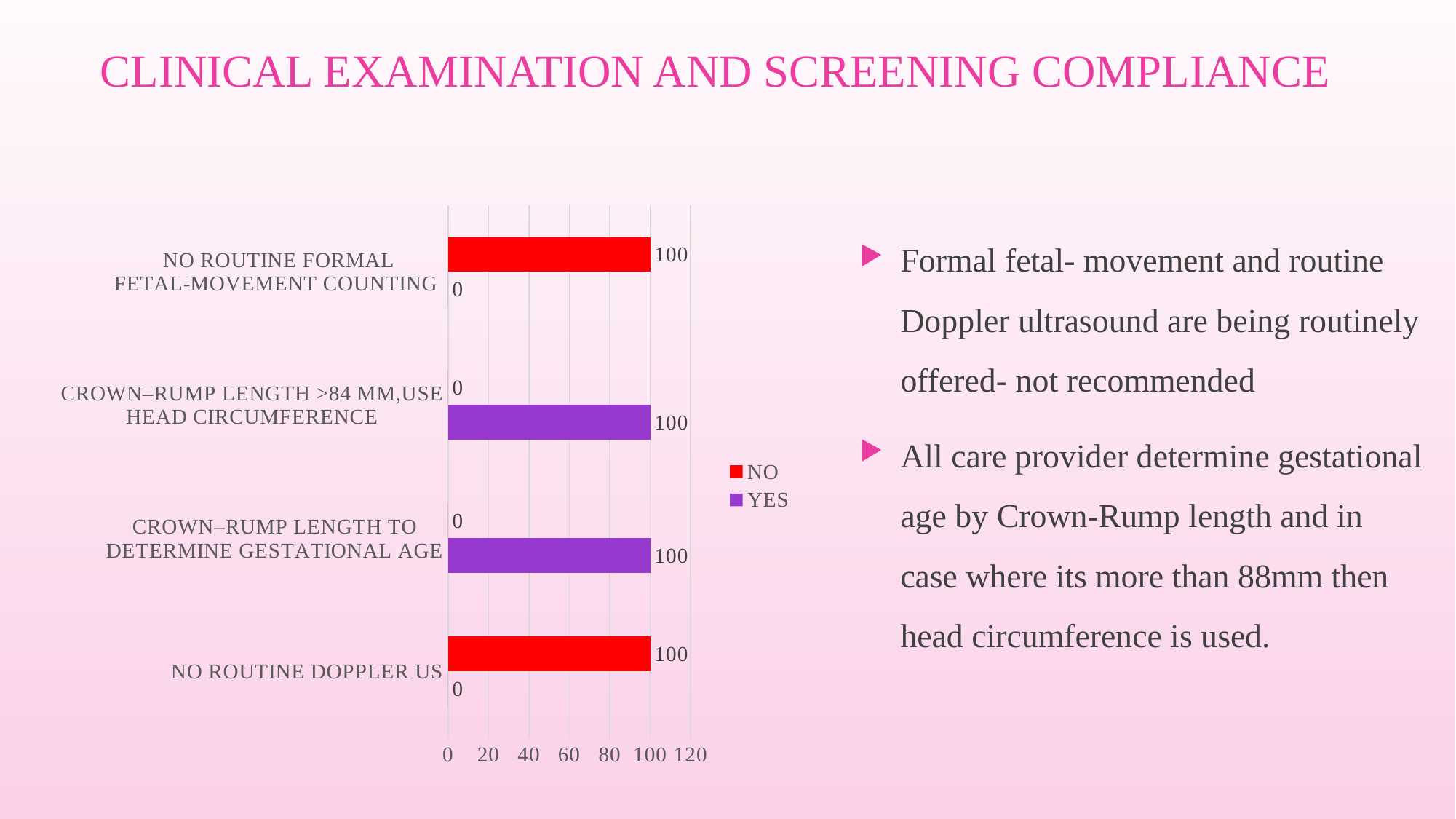
What is the NO value for NO ROUTINE FORMAL FETAL-MOVEMENT COUNTING? 100 What is the NO value for CROWN–RUMP LENGTH TO DETERMINE GESTATIONAL AGE? 0 Which is larger for NO ROUTINE DOPPLER US, the NO value or the YES value? NO What is the YES value for CROWN–RUMP LENGTH >84 MM, USE HEAD CIRCUMFERENCE? 100 What kind of chart is shown on the slide? bar chart What colour are the bars for the NO series? red How many series does the chart legend list? 2 How many categories are shown on the chart? 4 What are the two entries in the chart legend? NO and YES What is the NO value for NO ROUTINE DOPPLER US? 100 What is the difference between the YES and NO values for CROWN–RUMP LENGTH TO DETERMINE GESTATIONAL AGE? 100 What is the YES value for NO ROUTINE FORMAL FETAL-MOVEMENT COUNTING? 0